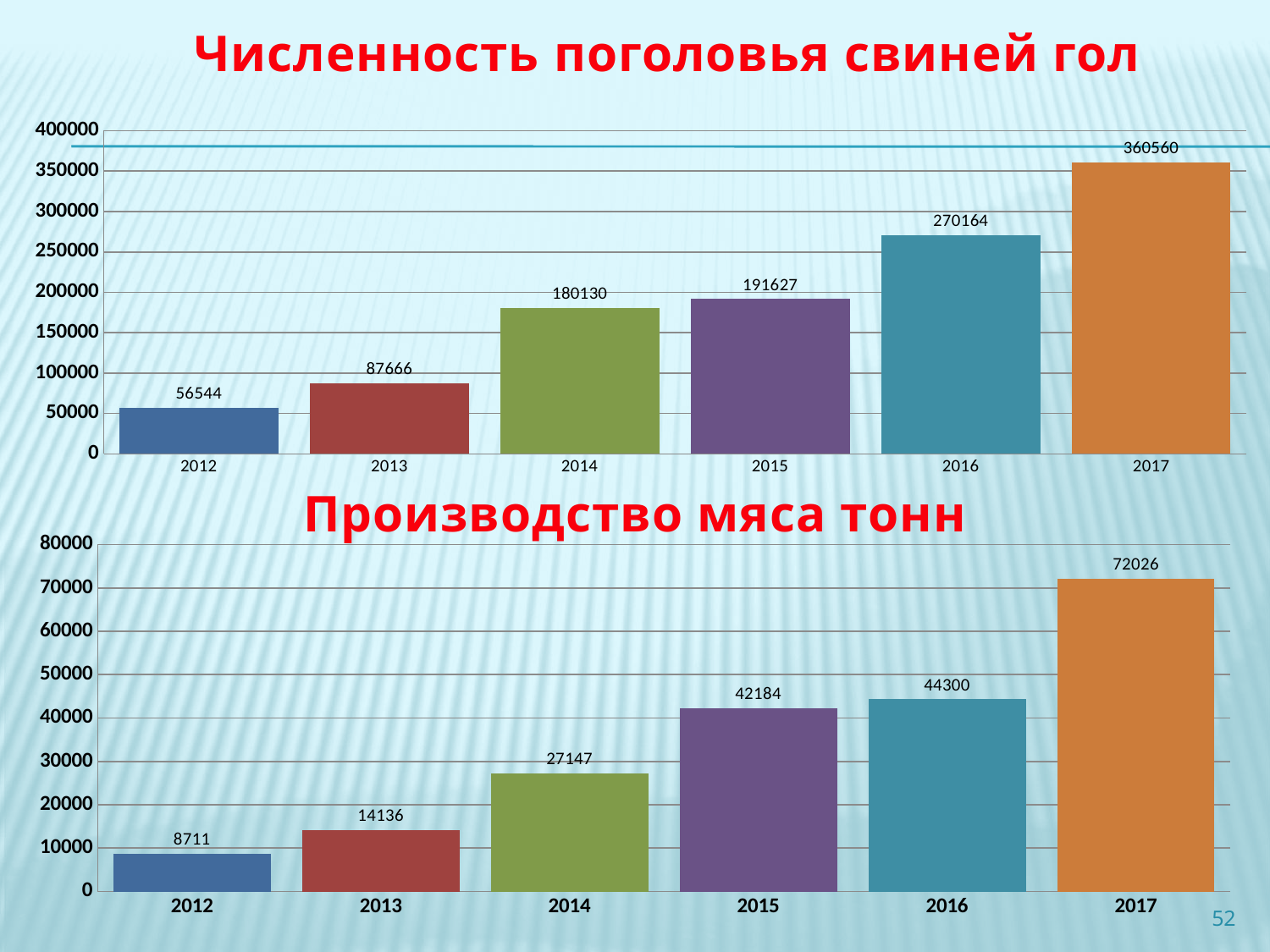
In the bottom chart 'Производство мяса тонн', what is the value for 2013? 14136 In the top chart 'Численность поголовья свиней гол', do the values rise or fall from 2012 to 2017? rise In the top chart 'Численность поголовья свиней гол', how many years are shown on the x axis? 6 In the bottom chart 'Производство мяса тонн', what colour is the bar for 2017? orange In the top chart 'Численность поголовья свиней гол', what is the value for 2014? 180130 In the top chart 'Численность поголовья свиней гол', what is the difference between the values for 2017 and 2016? 90396 What kind of chart is the bottom chart 'Производство мяса тонн'? bar chart In the bottom chart 'Производство мяса тонн', what is the difference between the values for 2017 and 2012? 63315 In the bottom chart 'Производство мяса тонн', what is the value for 2016? 44300 In the top chart 'Численность поголовья свиней гол', which year has the lowest value? 2012 In the bottom chart 'Производство мяса тонн', which is larger, the value for 2015 or the value for 2014? 2015 In the top chart 'Численность поголовья свиней гол', which year has the highest value? 2017